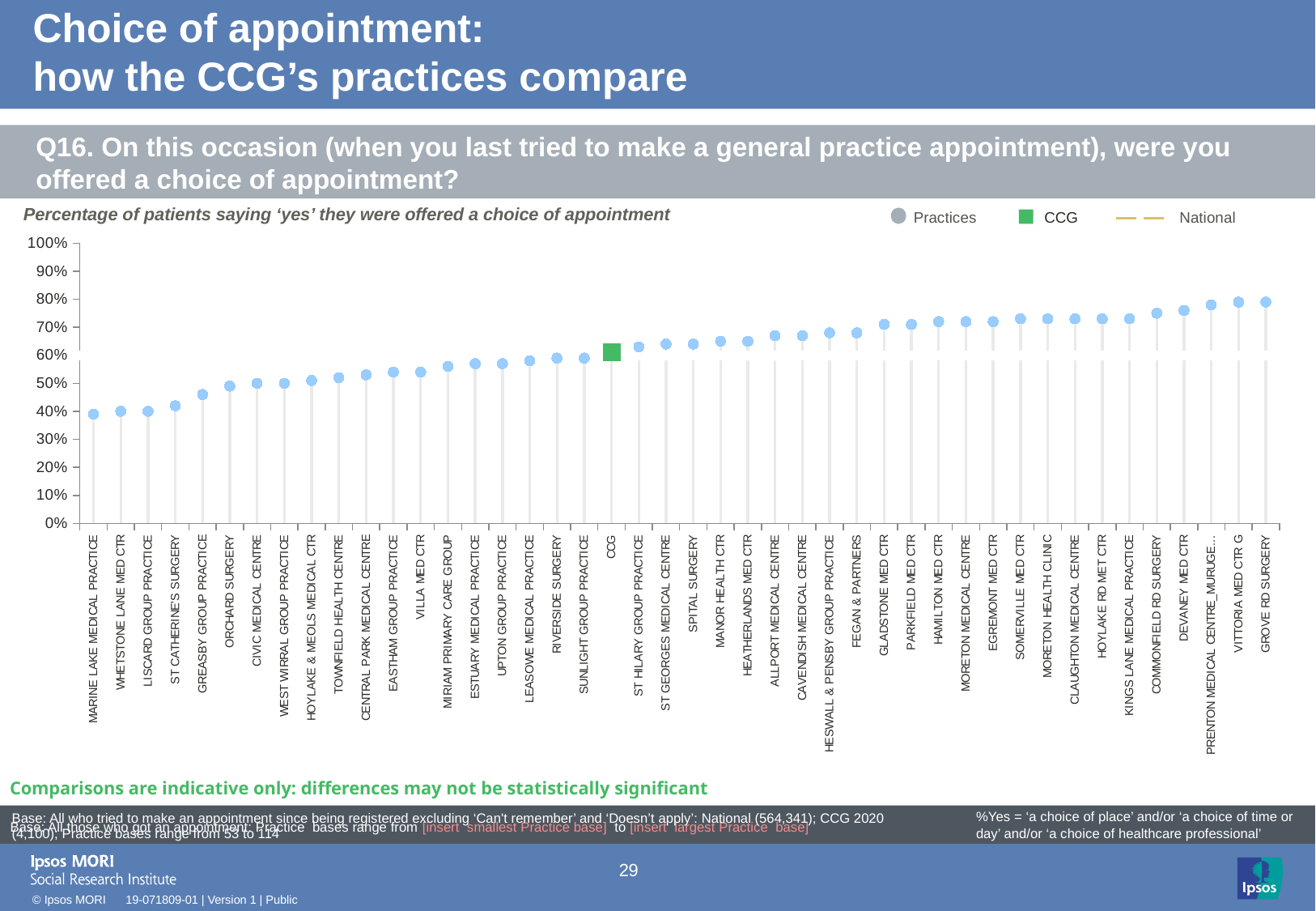
Is the value for HAMILTON MED CTR greater or less than 60%? greater Is the value for GROVE RD SURGERY greater or less than 70%? greater Is the value for ST CATHERINE'S SURGERY greater or less than 50%? less Do the values rise or fall moving from left to right along the x axis? rise How many categories are plotted along the x axis, including CCG? 44 Which has the higher value, MARINE LAKE MEDICAL PRACTICE or GROVE RD SURGERY? GROVE RD SURGERY What colour is the marker used for the CCG in the chart? green Which has the higher value, CCG or LISCARD GROUP PRACTICE? CCG How many series does the legend list? 3